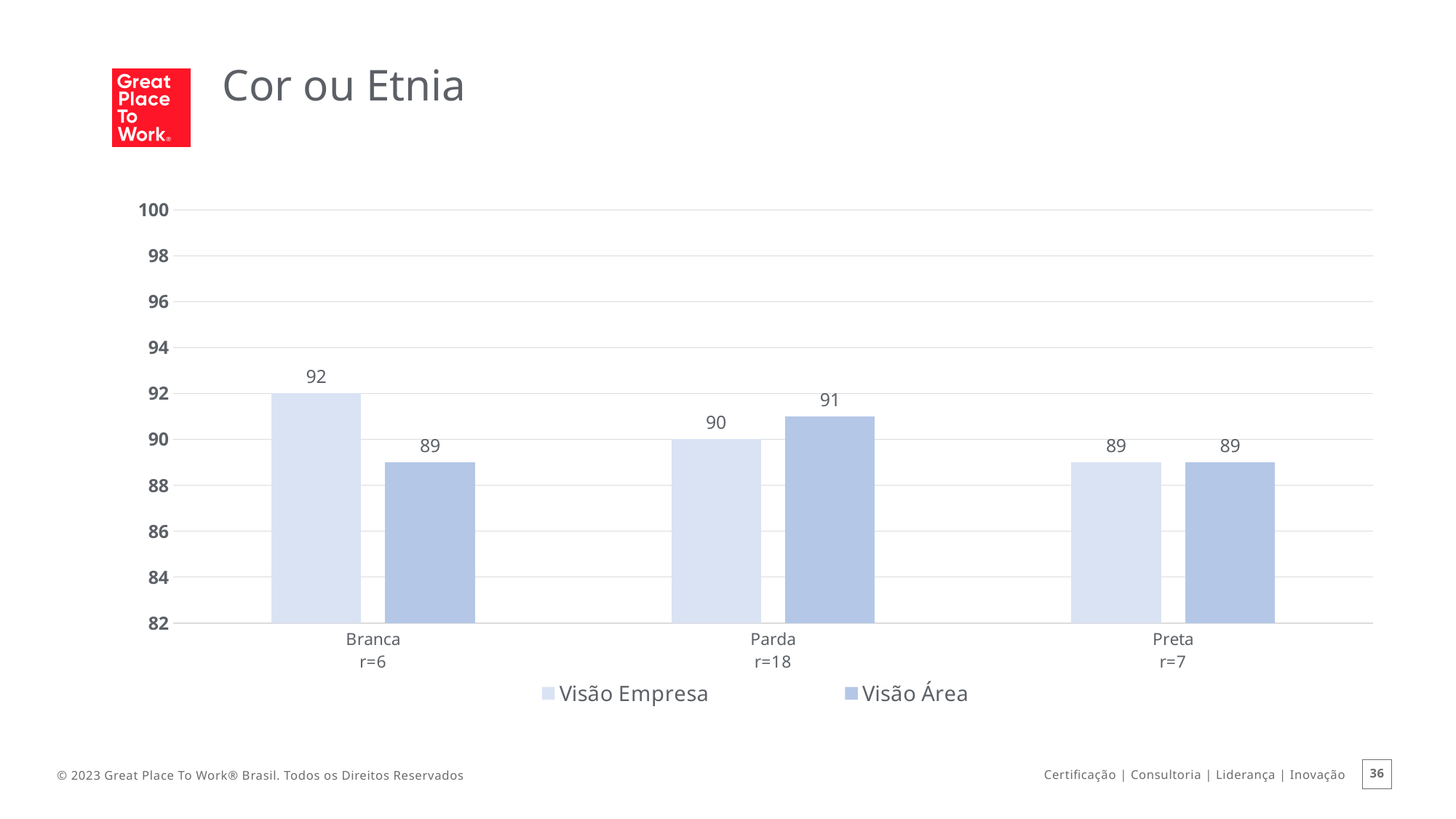
Is the Visão Área value for Branca greater or less than 90? less What kind of chart is shown on the slide? bar chart For Parda, which is larger: Visão Empresa or Visão Área? Visão Área What is the Visão Área value for Parda? 91 What is the difference between the Visão Empresa and Visão Área values for Branca? 3 What is the Visão Empresa value for Branca? 92 Which category has the lowest Visão Área value? Branca and Preta (both 89) How many series does the legend list? 2 How many categories are shown on the x axis? 3 What is the Visão Empresa value for Preta? 89 Which category has the highest Visão Empresa value? Branca What is the title of the slide? Cor ou Etnia